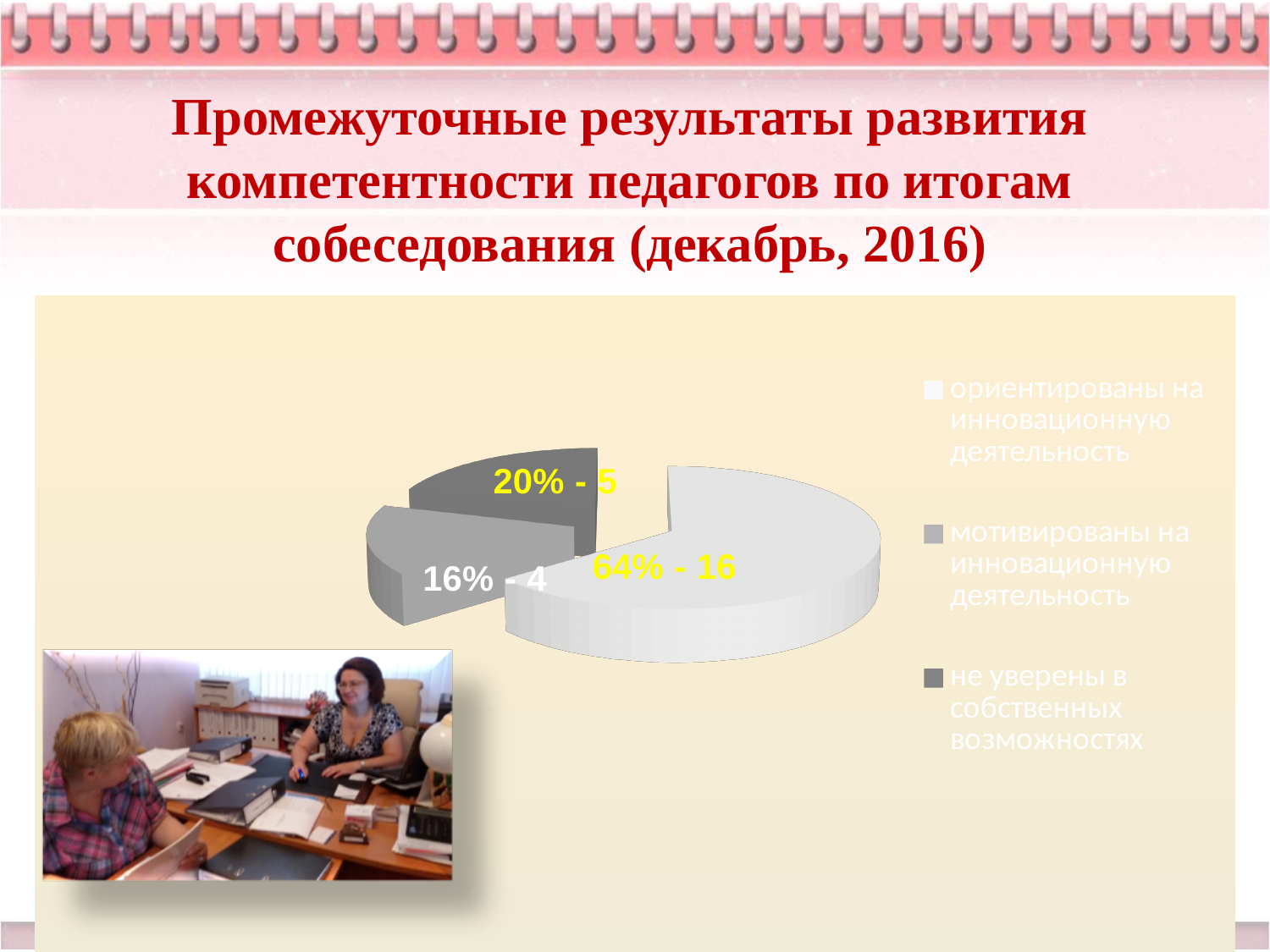
How many teachers does the 16% slice of the pie chart represent? 4 What is the first entry listed in the legend of the pie chart? ориентированы на инновационную деятельность Which slice is larger: the one with 5 teachers or the one with 4 teachers? the one with 5 teachers (20%) What is the difference in the number of teachers between the 64% slice and the 16% slice? 12 What is the label of the largest slice of the pie chart? 64% - 16 What is the total number of teachers across all slices of the pie chart? 25 What is the label of the smallest slice of the pie chart? 16% - 4 How many teachers does the 64% slice of the pie chart represent? 16 How many teachers does the 20% slice of the pie chart represent? 5 How many slices does the pie chart have? 3 What kind of chart is shown on the slide? pie chart How many entries does the legend of the pie chart list? 3